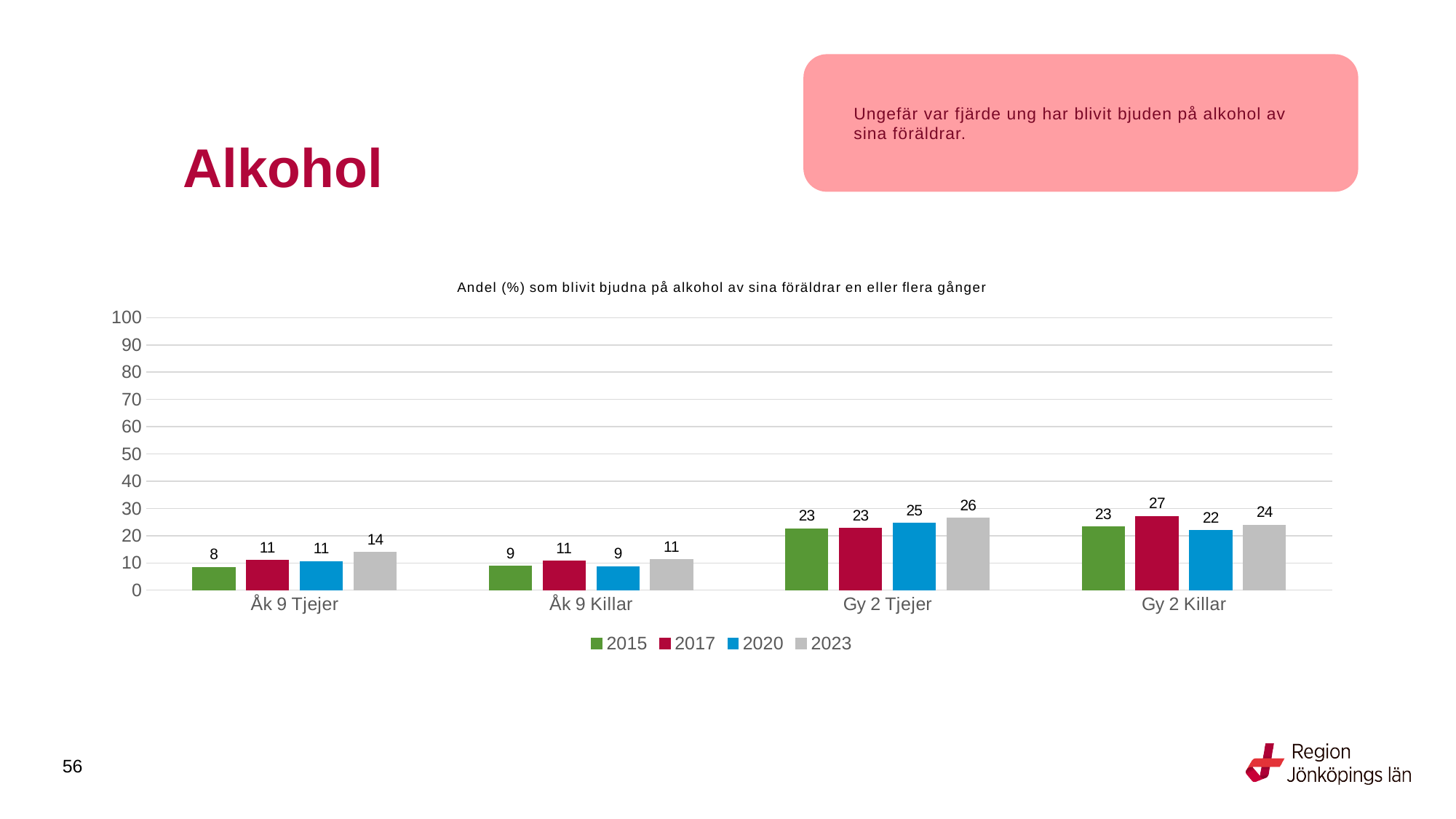
What is the difference between the 2023 and 2015 values for Gy 2 Tjejer? 3 What is the value for Åk 9 Killar in 2020? 9 What is the value for Gy 2 Killar in 2017? 27 Is the value for Gy 2 Tjejer in 2020 greater or less than 20? greater How many series does the legend list? 4 What is the value for Åk 9 Tjejer in 2023? 14 What kind of chart is shown on the slide? bar chart Which category has the highest value in the 2023 series? Gy 2 Tjejer How many categories are shown on the x axis? 4 Which category has the lowest value in the 2015 series? Åk 9 Tjejer Which is larger: the 2017 value for Gy 2 Killar or the 2017 value for Gy 2 Tjejer? Gy 2 Killar What is the title of the chart? Andel (%) som blivit bjudna på alkohol av sina föräldrar en eller flera gånger